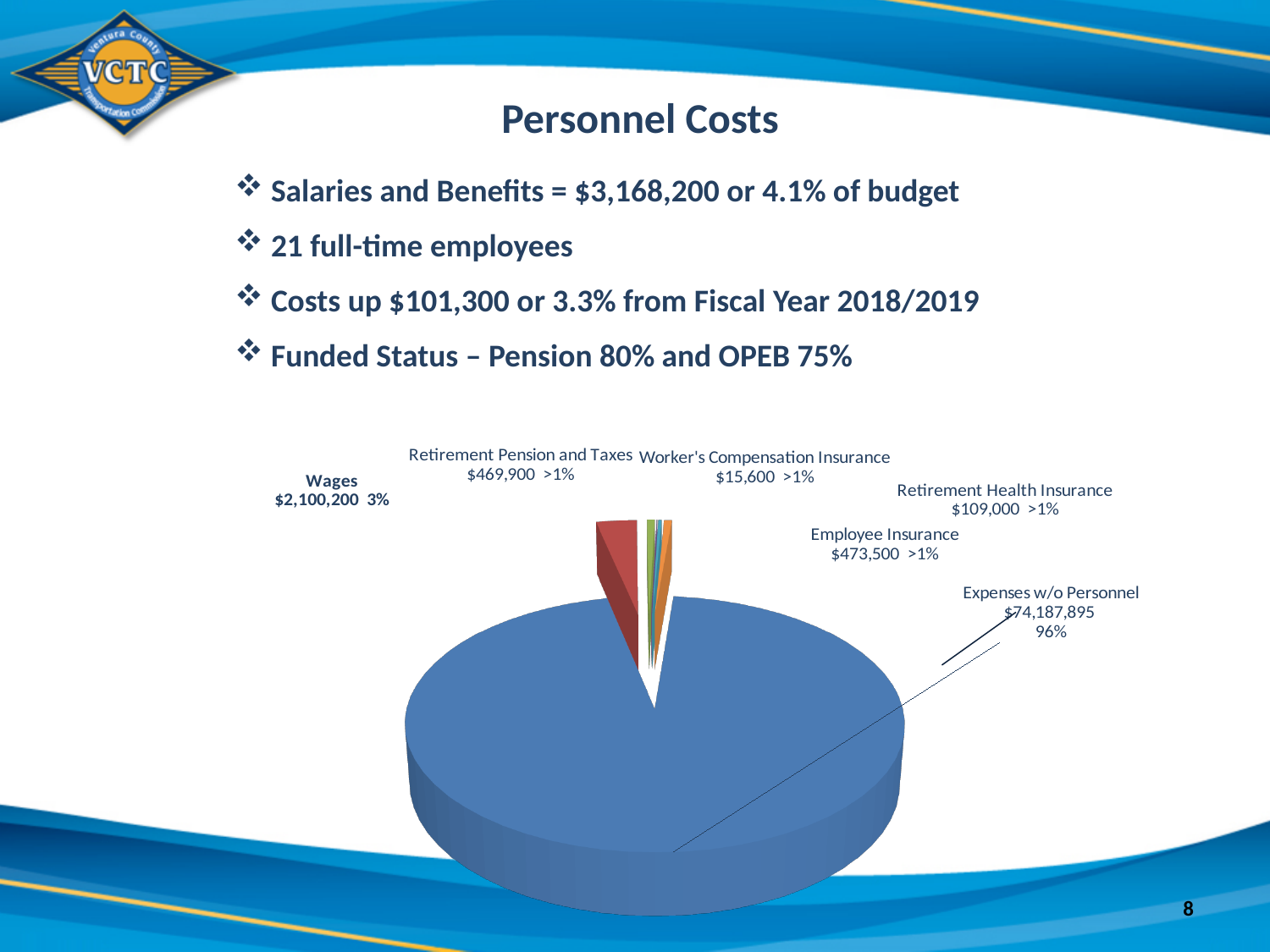
What is the difference between the Retirement Health Insurance value and the Worker's Compensation Insurance value? $93,400 How many slices does the pie chart have? 6 What is the value shown for Expenses w/o Personnel in the pie chart? $74,187,895 What share of the pie does Expenses w/o Personnel represent? 96% What is the difference between the Employee Insurance value and the Retirement Pension and Taxes value? $3,600 What kind of chart is shown on the slide? Pie chart Which category has the smallest value in the pie chart? Worker's Compensation Insurance Which category has the largest slice in the pie chart? Expenses w/o Personnel What is the value shown for Wages in the pie chart? $2,100,200 What is the value shown for Retirement Health Insurance in the pie chart? $109,000 Which is larger, the value for Wages or the value for Employee Insurance? Wages What is the value shown for Worker's Compensation Insurance in the pie chart? $15,600